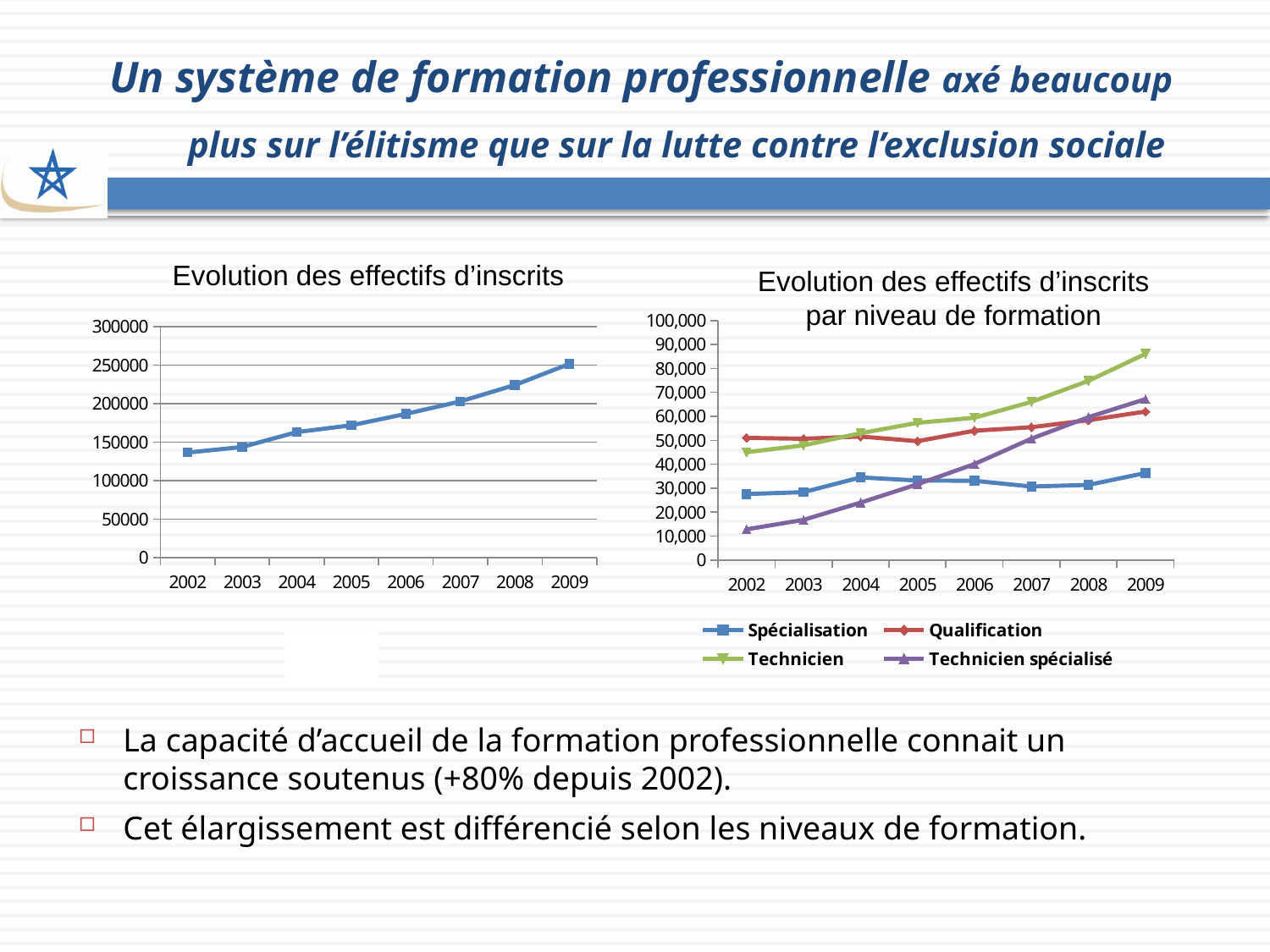
In the left chart 'Evolution des effectifs d'inscrits', how many years are plotted on the x axis? 8 What kind of chart is the left chart titled 'Evolution des effectifs d'inscrits'? line chart In the right chart 'Evolution des effectifs d'inscrits par niveau de formation', does the Technicien spécialisé series rise or fall from 2002 to 2009? rise In the left chart 'Evolution des effectifs d'inscrits', is the value for 2009 greater or less than 200000? greater In the left chart 'Evolution des effectifs d'inscrits', which year has the highest value? 2009 In the left chart 'Evolution des effectifs d'inscrits', which year has the lowest value? 2002 In the right chart 'Evolution des effectifs d'inscrits par niveau de formation', which series has the lowest value in 2002? Technicien spécialisé In the right chart 'Evolution des effectifs d'inscrits par niveau de formation', which series has the highest value in 2009? Technicien In the left chart 'Evolution des effectifs d'inscrits', do the values rise or fall from 2002 to 2009? rise In the right chart 'Evolution des effectifs d'inscrits par niveau de formation', is the value for Technicien in 2009 greater or less than 80,000? greater In the right chart 'Evolution des effectifs d'inscrits par niveau de formation', how many series does the legend list? 4 In the left chart 'Evolution des effectifs d'inscrits', is the value for 2002 greater or less than 150000? less